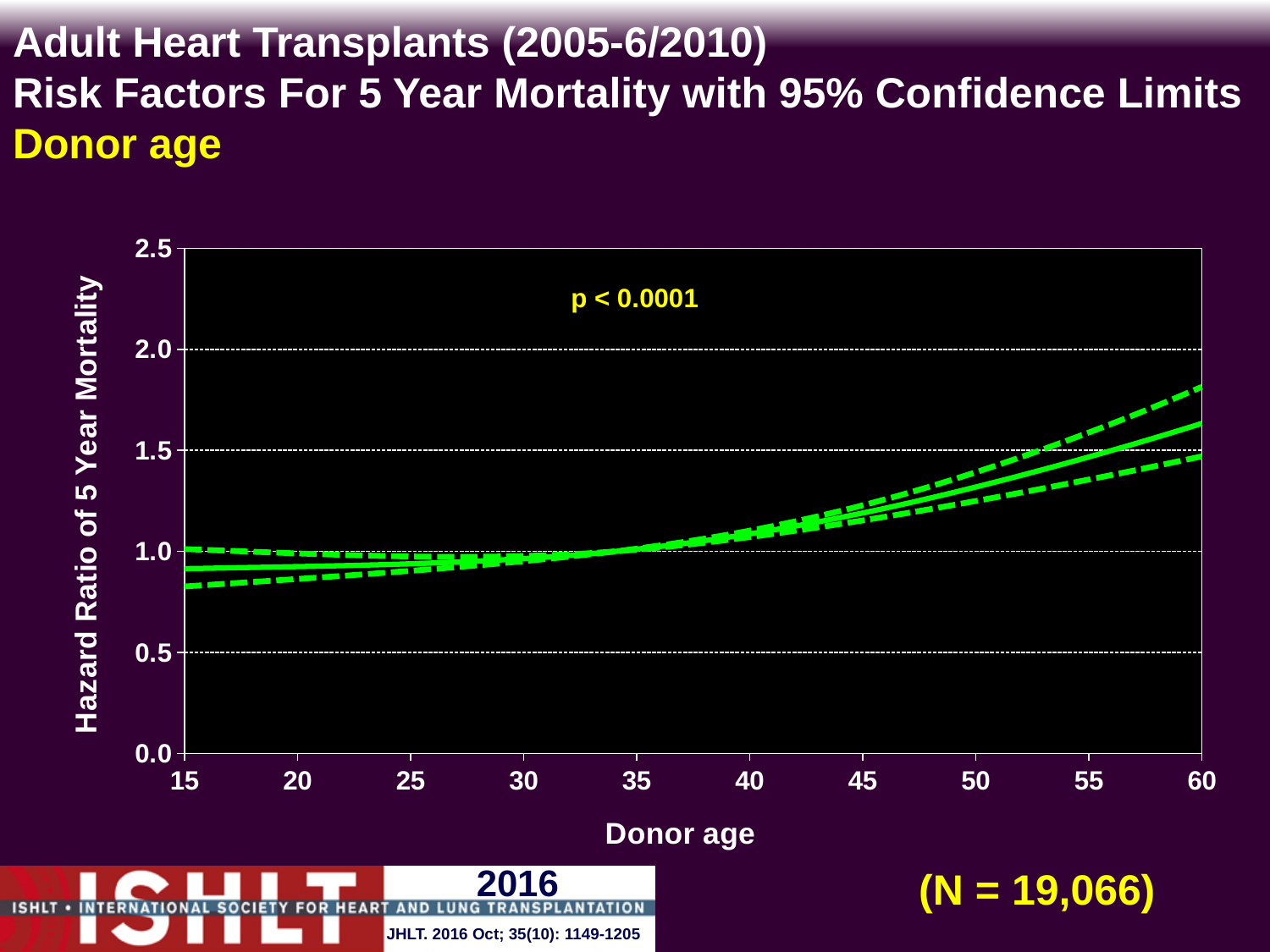
How many lines are plotted on the chart? 3 What p-value is printed on the chart? p < 0.0001 Is the hazard ratio (solid line) at donor age 60 greater or less than 1.5? greater At which donor age, 15 or 60, is the hazard ratio higher? 60 What kind of chart is shown on the slide? line chart Is the upper 95% confidence limit at donor age 60 greater or less than 2.0? less Is the lower 95% confidence limit at donor age 60 greater or less than 1.0? greater Does the hazard ratio of 5 year mortality rise or fall as donor age increases from 15 to 60? rise What is the label of the y axis? Hazard Ratio of 5 Year Mortality